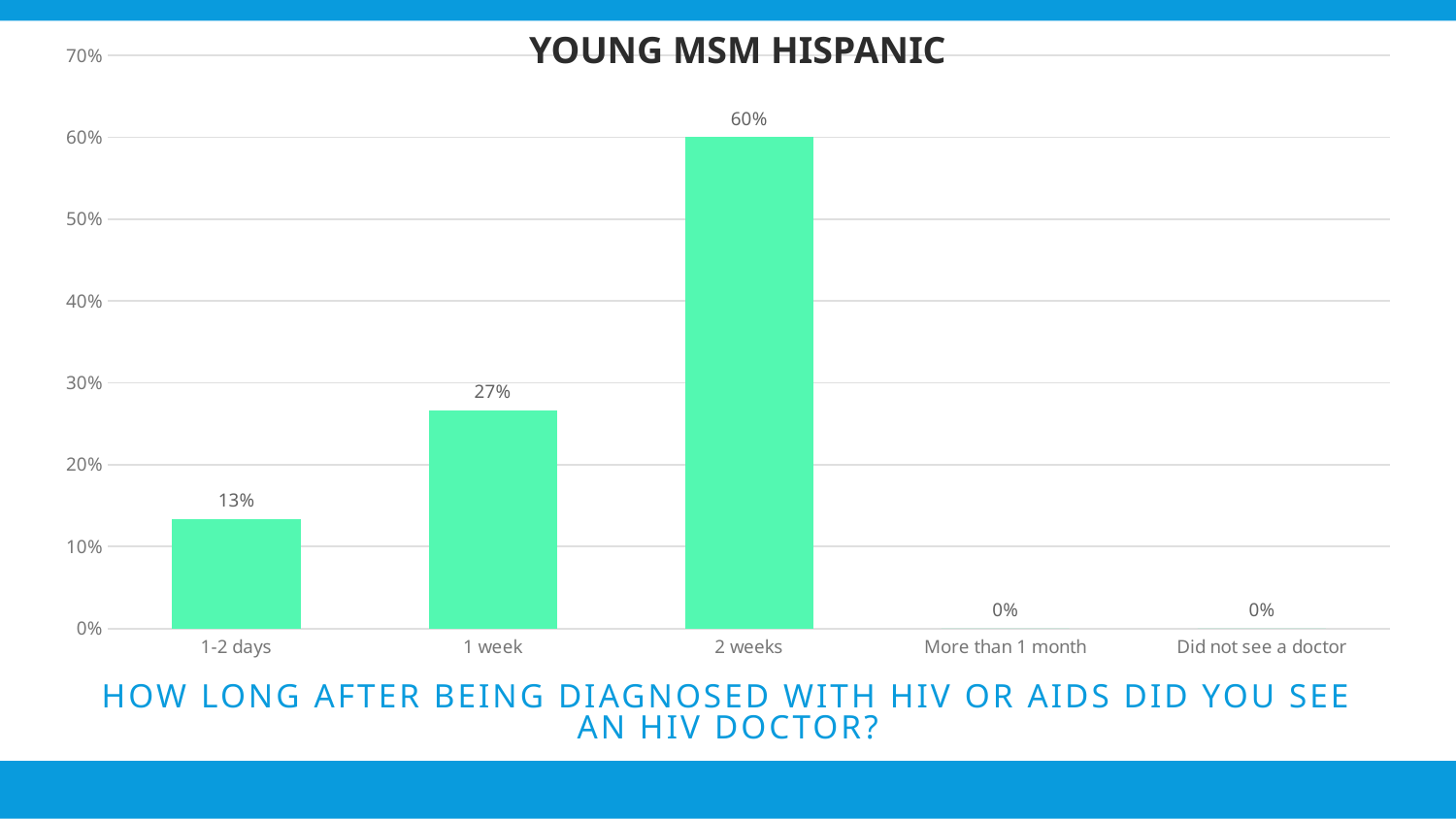
What is the value for 2 weeks? 60% What is the difference between the values for 1 week and 1-2 days? 14% How many categories are shown on the x axis? 5 What is the value for 1-2 days? 13% Is the value for 2 weeks greater or less than 50%? greater What kind of chart is this? bar chart What is the difference between the values for 2 weeks and 1 week? 33% Which category has the highest value? 2 weeks What is the title of the chart? YOUNG MSM HISPANIC What is the value for 1 week? 27% Which is larger, the value for 1-2 days or the value for 1 week? 1 week What is the value for More than 1 month? 0%